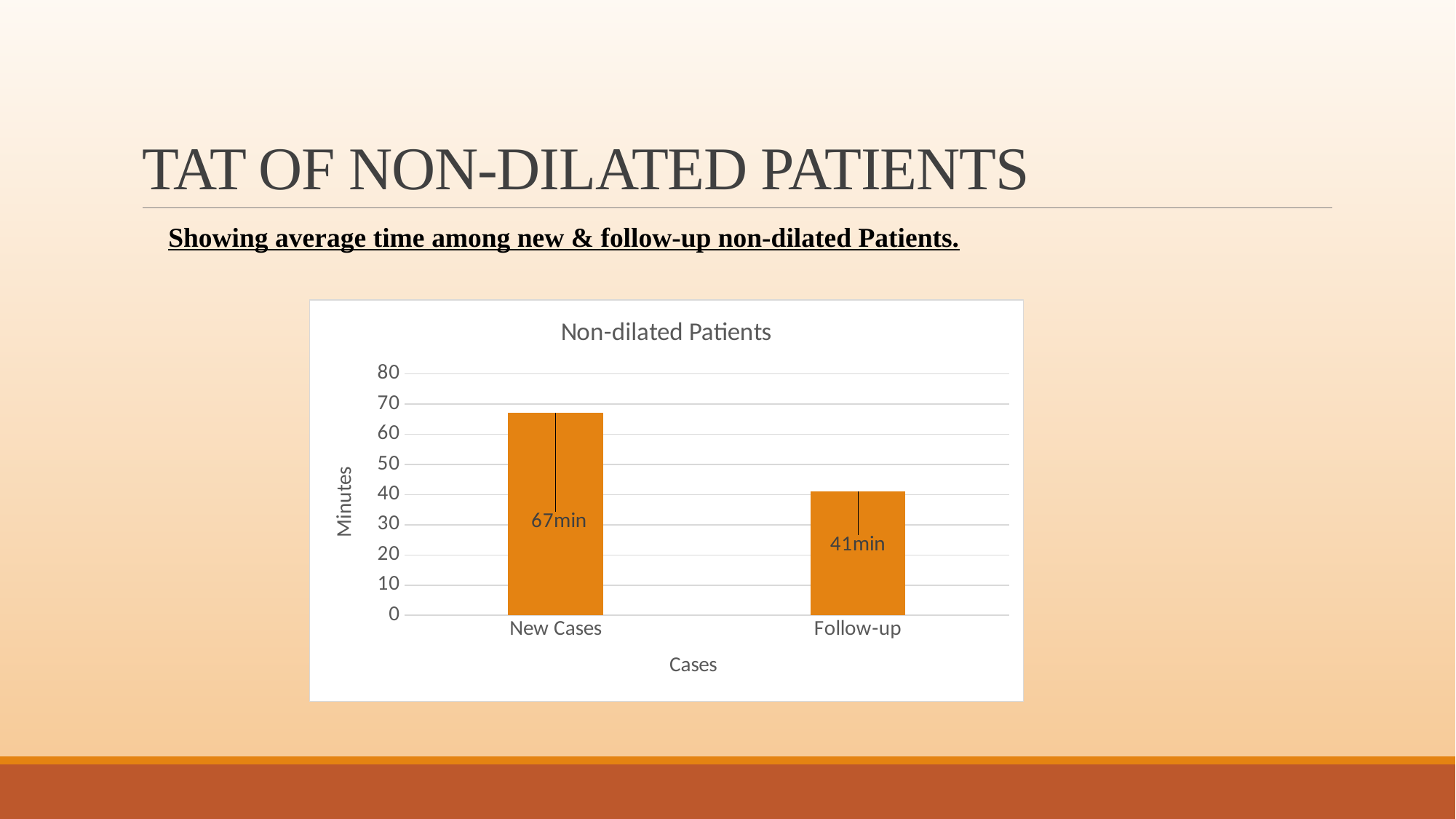
What is the value for Follow-up? 41min Which category has the lowest value? Follow-up What is the value for New Cases? 67min What is the title of the chart? Non-dilated Patients Is the value for New Cases greater or less than 60? greater Which is larger, the value for New Cases or the value for Follow-up? New Cases How many categories are shown on the x axis? 2 Which category has the highest value? New Cases Is the value for Follow-up greater or less than 50? less What is the label of the vertical axis? Minutes What is the difference in minutes between New Cases and Follow-up? 26min What kind of chart is shown on the slide? bar chart